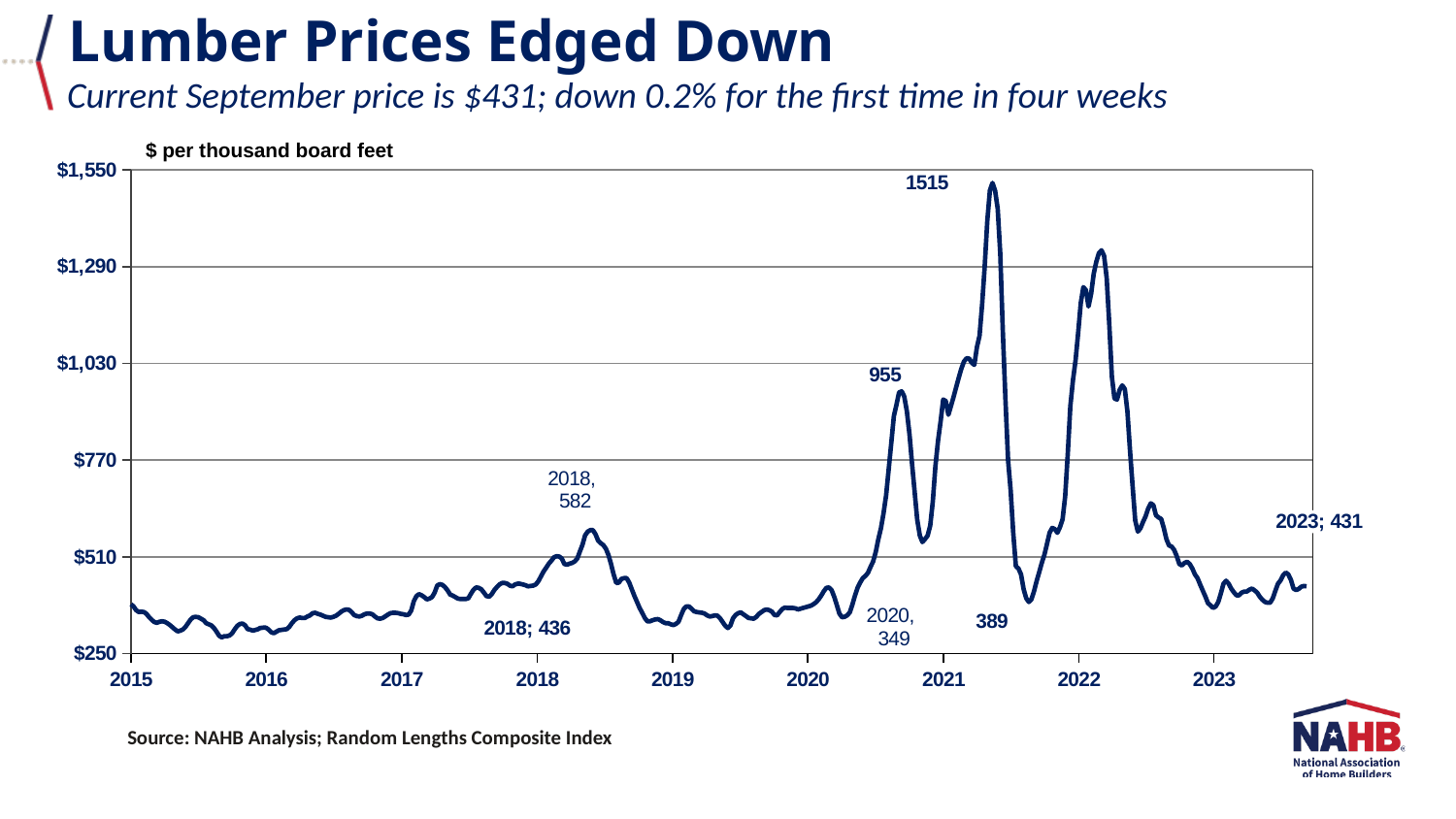
What is the labeled value for 2023 at the end of the line? 431 Which labeled value is larger, the 955 peak or the 2018 peak of 582? 955 What kind of chart is shown on the slide? line chart What is the labeled 2018 peak value? 582 What unit is given for the y axis? $ per thousand board feet Is the peak value in 2022 greater or less than $1,030? greater What is the labeled low value in 2020? 349 Is the value at the start of 2019 greater or less than $510? less What is the lowest labeled value on the chart? 349 What is the highest labeled value on the chart? 1515 What is the difference between the 1515 peak and the 955 peak? 560 What is the difference between the 2018 labeled values 582 and 436? 146